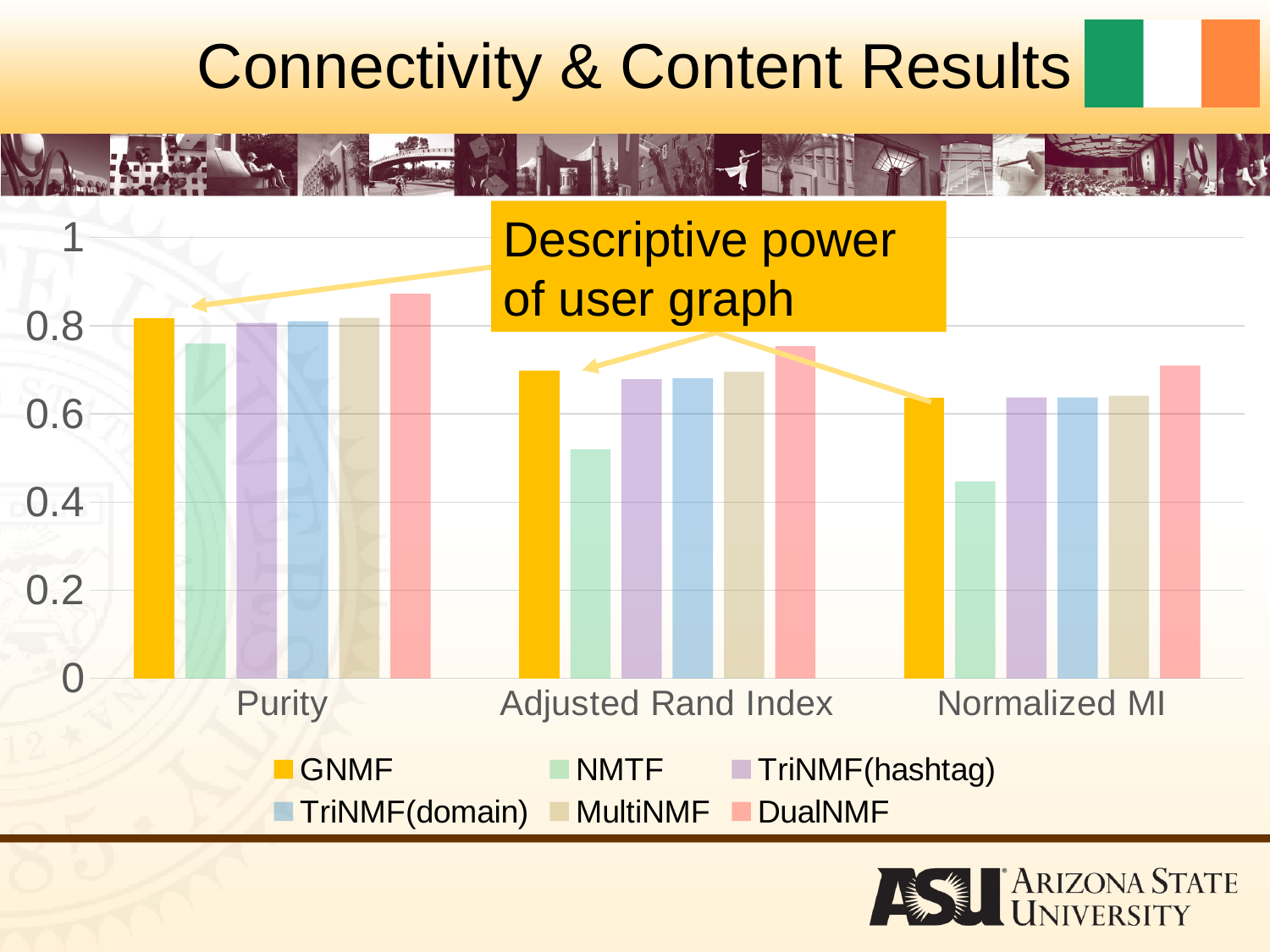
How many categories are shown along the x axis of the chart? 3 Which series has the highest value for Adjusted Rand Index? DualNMF Is the value for DualNMF in Purity greater or less than 0.8? greater What text is shown in the callout box on the chart? Descriptive power of user graph Which series has the highest value for Purity? DualNMF Is the value for NMTF in Normalized MI greater or less than 0.6? less How many series does the chart's legend list? 6 What kind of chart is shown on the slide? bar chart Which series has the lowest value for Adjusted Rand Index? NMTF Which series has the lowest value for Normalized MI? NMTF Which is larger: the GNMF value for Purity or the GNMF value for Normalized MI? Purity Is the value for NMTF in Adjusted Rand Index greater or less than 0.6? less